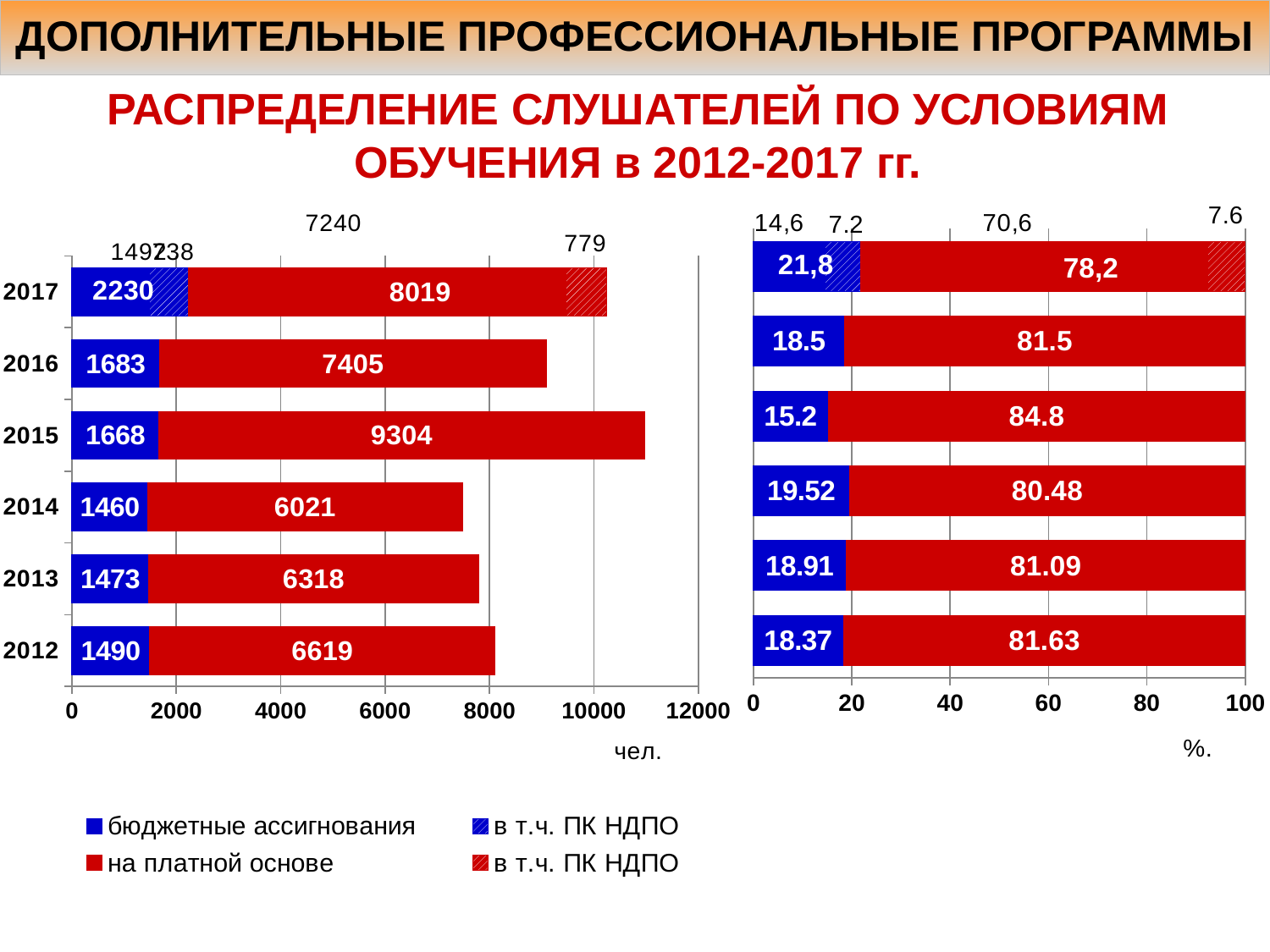
In the right chart, which year has the lowest share for бюджетные ассигнования? 2015 In the left chart, which year has the lowest value for на платной основе? 2014 How many entries does the legend list? 4 How many years are shown on the left chart? 6 In the right chart, which year has the highest share for бюджетные ассигнования? 2017 In the left chart, what is the value for на платной основе in 2015? 9304 In the left chart, which is larger: бюджетные ассигнования in 2016 or in 2015? 2016 In the left chart, what is the difference between the на платной основе values for 2013 and 2014? 297 In the left chart, what is the total of the бюджетные ассигнования and на платной основе values for 2012? 8109 In the left chart, which year has the highest value for на платной основе? 2015 In the left chart, what is the value for бюджетные ассигнования in 2017? 2230 In the right chart, what is the percentage for на платной основе in 2014? 80.48